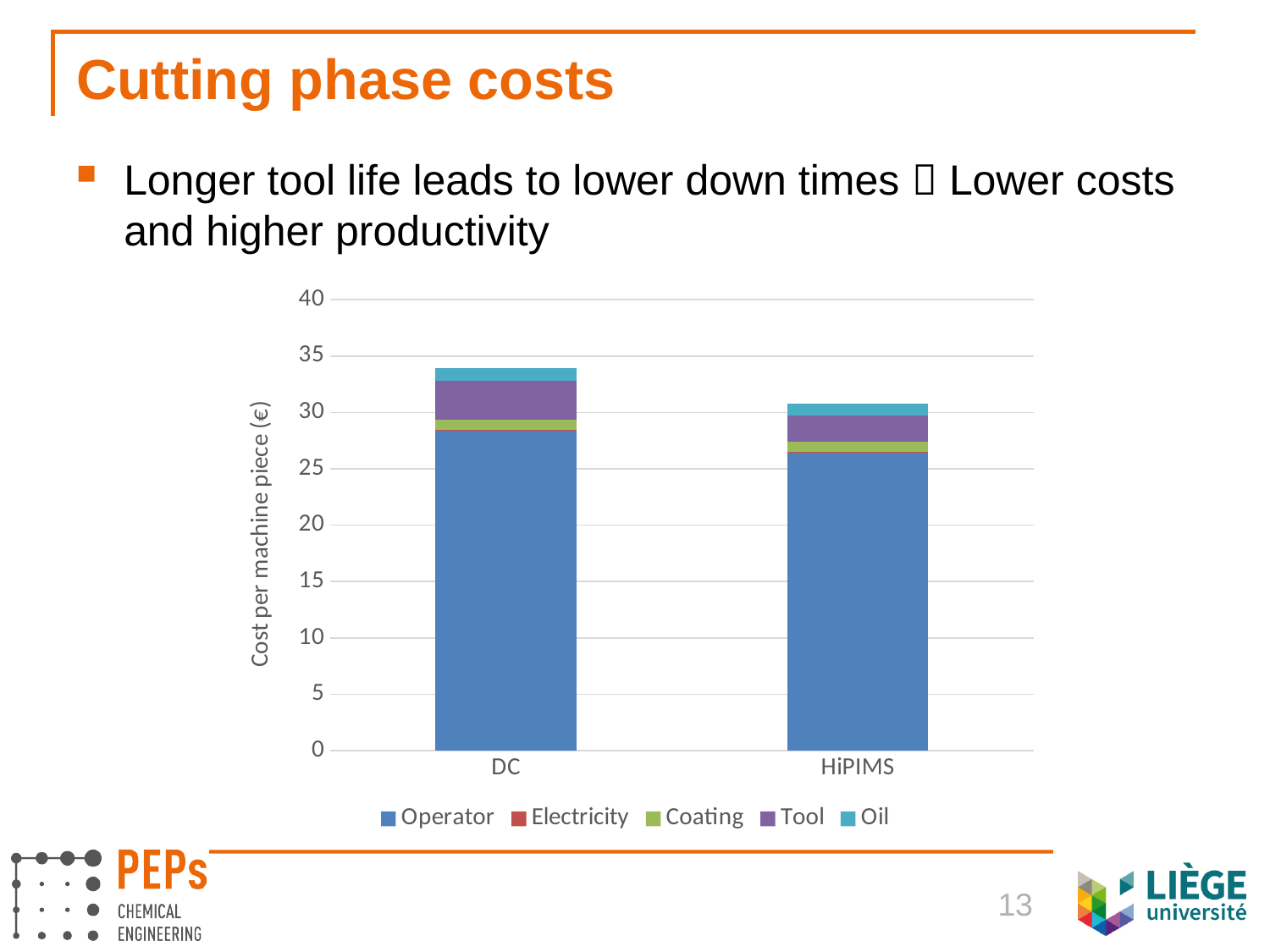
Is the Operator cost for HiPIMS greater or less than 25? greater Is the total cost per machine piece for DC greater or less than 35? less Is the total cost per machine piece for DC greater or less than 30? greater What is the label of the chart's vertical axis? Cost per machine piece (€) How many categories are shown on the x axis of the chart? 2 Which category has the higher total cost per machine piece, DC or HiPIMS? DC Which category has the lowest total cost per machine piece? HiPIMS Which series is listed last in the chart's legend? Oil What kind of chart is shown on the slide? Stacked bar chart How many series does the chart's legend list? 5